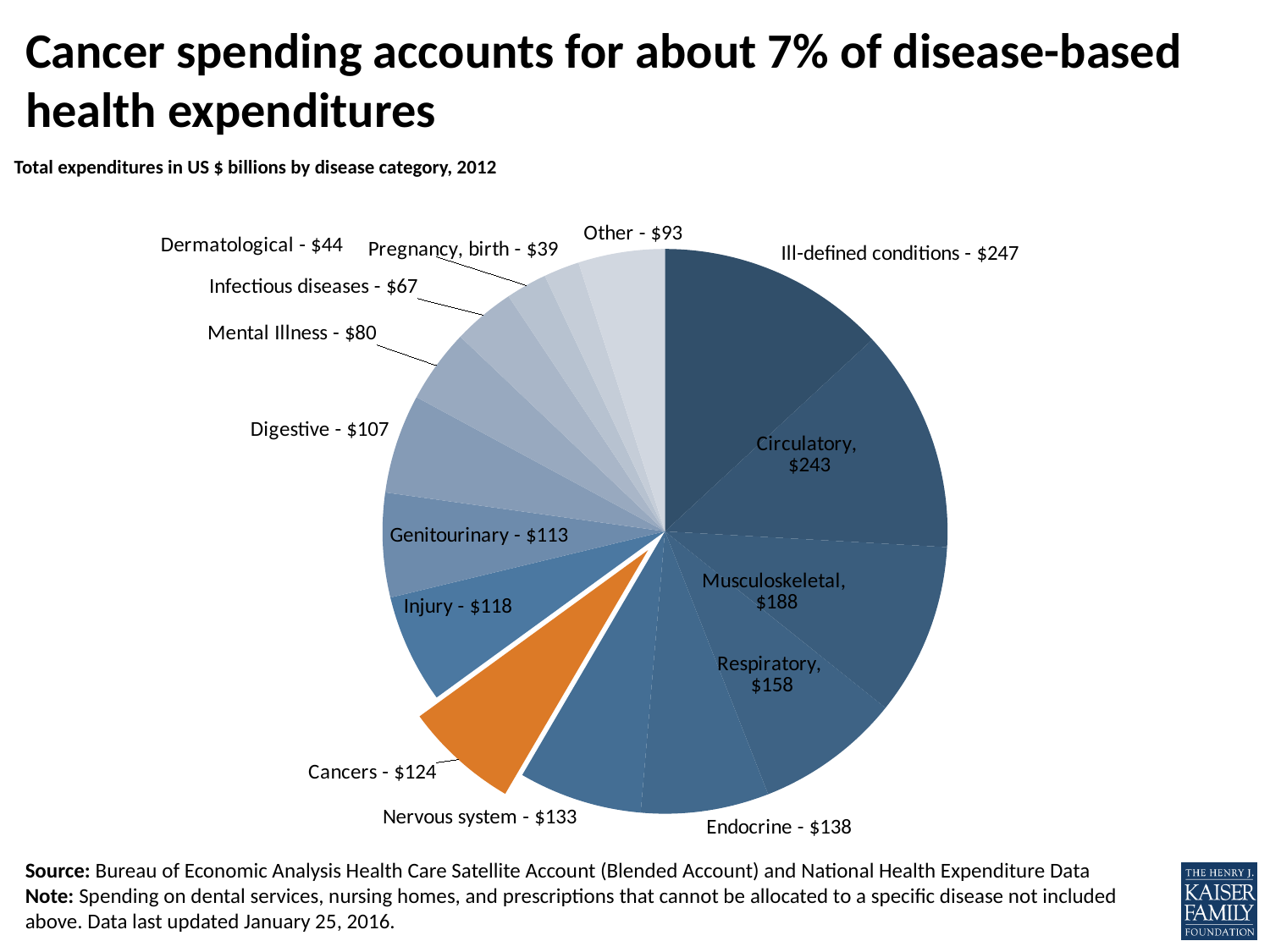
What is the value shown for Pregnancy, birth? $39 Which disease category has the largest expenditure? Ill-defined conditions What is the value shown for Circulatory? $243 What is the difference between Ill-defined conditions and Circulatory expenditures? $4 Which is larger, the expenditure for Digestive or for Genitourinary? Genitourinary What is the total expenditure for Cancers? $124 Which disease category has the smallest expenditure? Pregnancy, birth How many disease categories are shown in the pie chart? 15 What type of chart is shown on the slide? Pie chart Which is larger, the expenditure for Musculoskeletal or for Respiratory? Musculoskeletal What is the difference between Cancers and Injury expenditures? $6 Which slice of the pie chart is highlighted in orange? Cancers